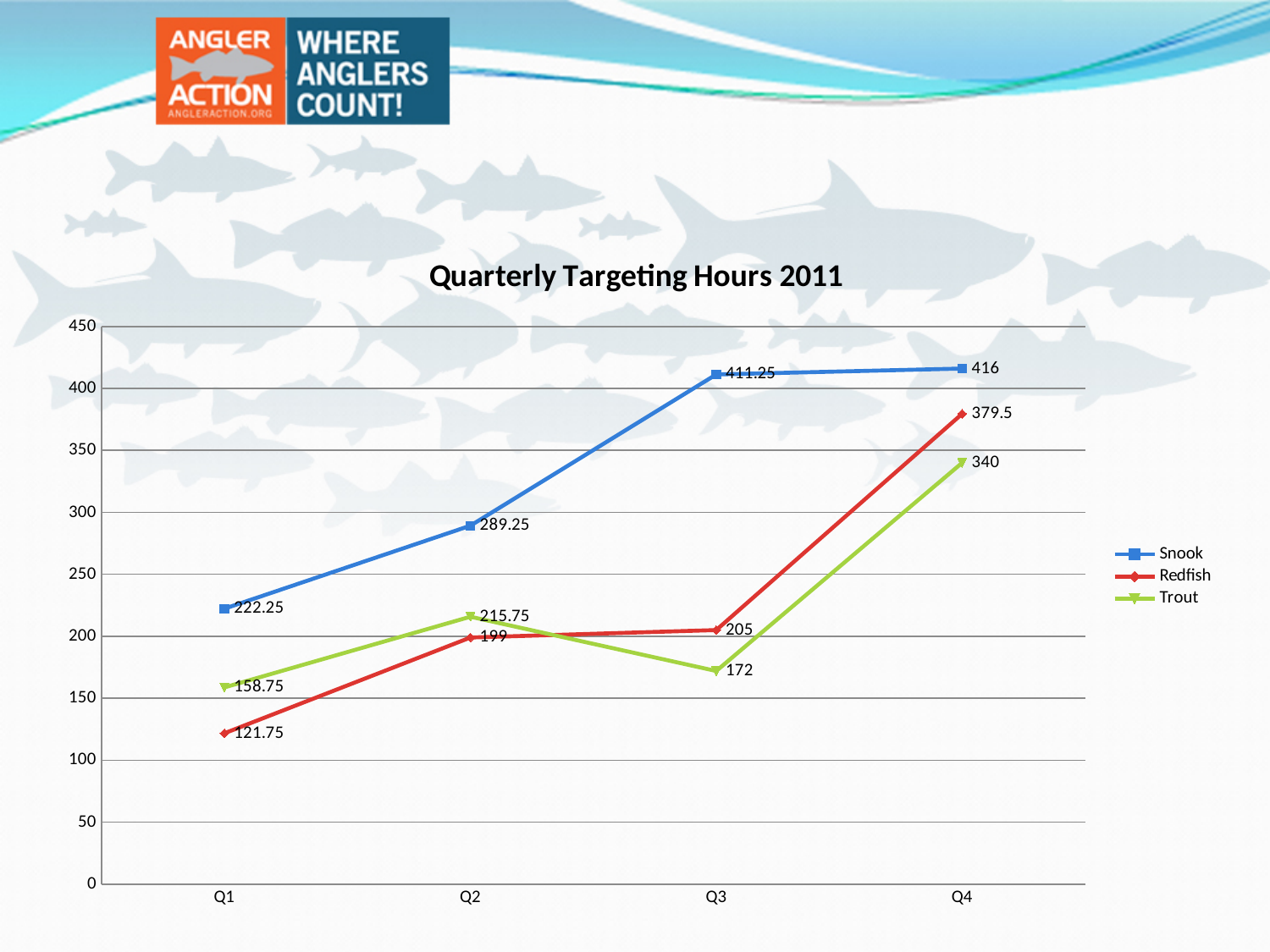
In which quarter is the Trout value lowest? Q1 How many quarters are shown on the x axis? 4 What is the Redfish value for Q1? 121.75 Does the Snook series rise or fall from Q1 to Q4? rise In which quarter is the Redfish value highest? Q4 Which is larger in Q2, the Redfish value or the Trout value? Trout What is the difference between the Snook and Redfish values in Q4? 36.5 How many series does the legend list? 3 What is the Trout value for Q2? 215.75 Is the Trout value for Q4 greater or less than 300? greater What kind of chart is shown? line chart What is the Snook value for Q3? 411.25